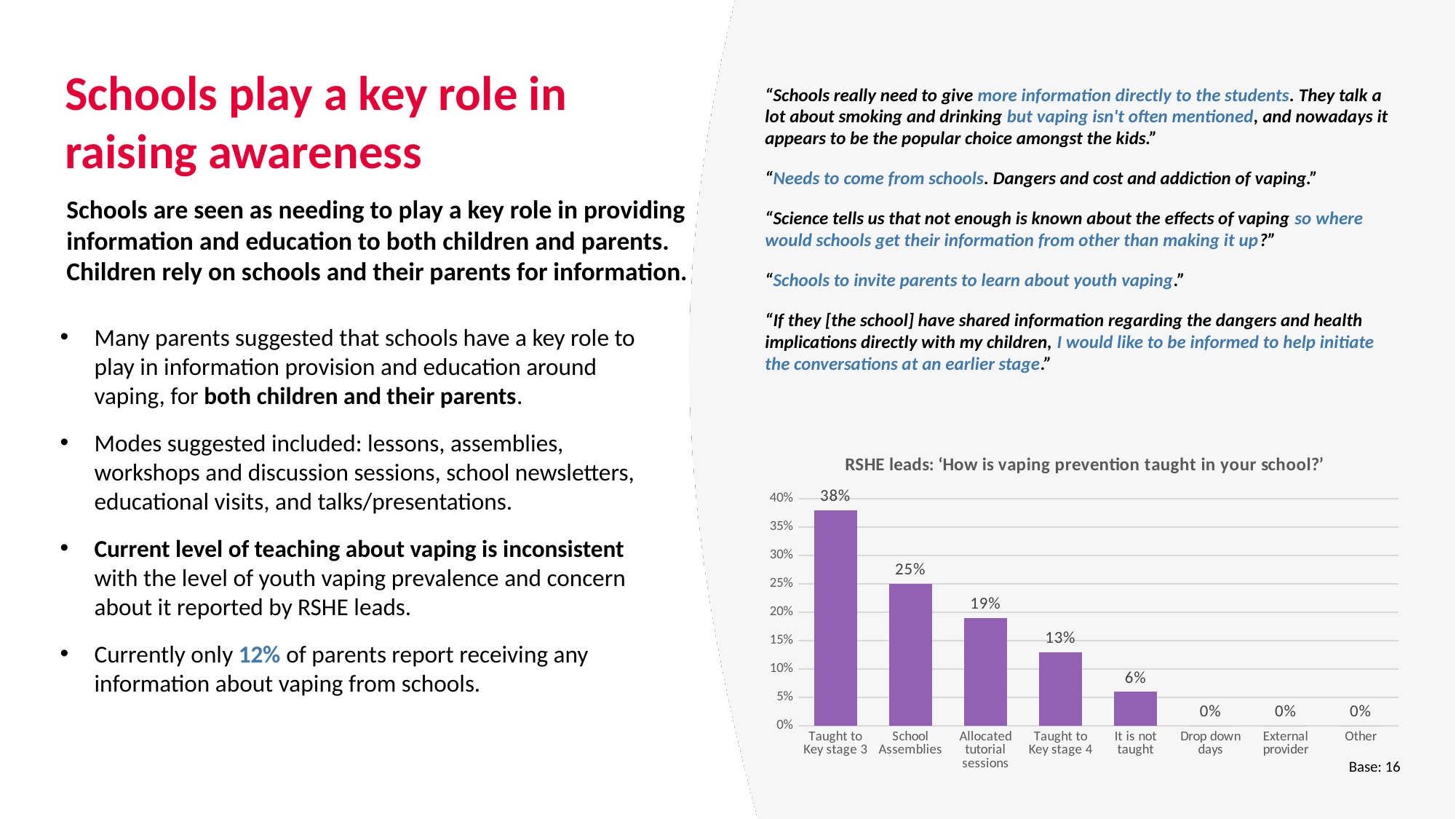
What is the title of the chart? RSHE leads: ‘How is vaping prevention taught in your school?’ Which is larger: the value for School Assemblies or the value for Allocated tutorial sessions? School Assemblies What value is shown for School Assemblies? 25% Which category has the highest value in the chart? Taught to Key stage 3 What percentage of RSHE leads said vaping prevention is taught to Key stage 3? 38% How many categories have a value of 0%? 3 What percentage is shown for 'It is not taught'? 6% What is the difference between the values for Taught to Key stage 3 and Taught to Key stage 4? 25% Do the values rise or fall moving from left to right along the x axis? Fall What value is shown for Allocated tutorial sessions? 19% How many categories are shown on the x axis of the chart? 8 What type of chart is shown on the slide? Bar chart